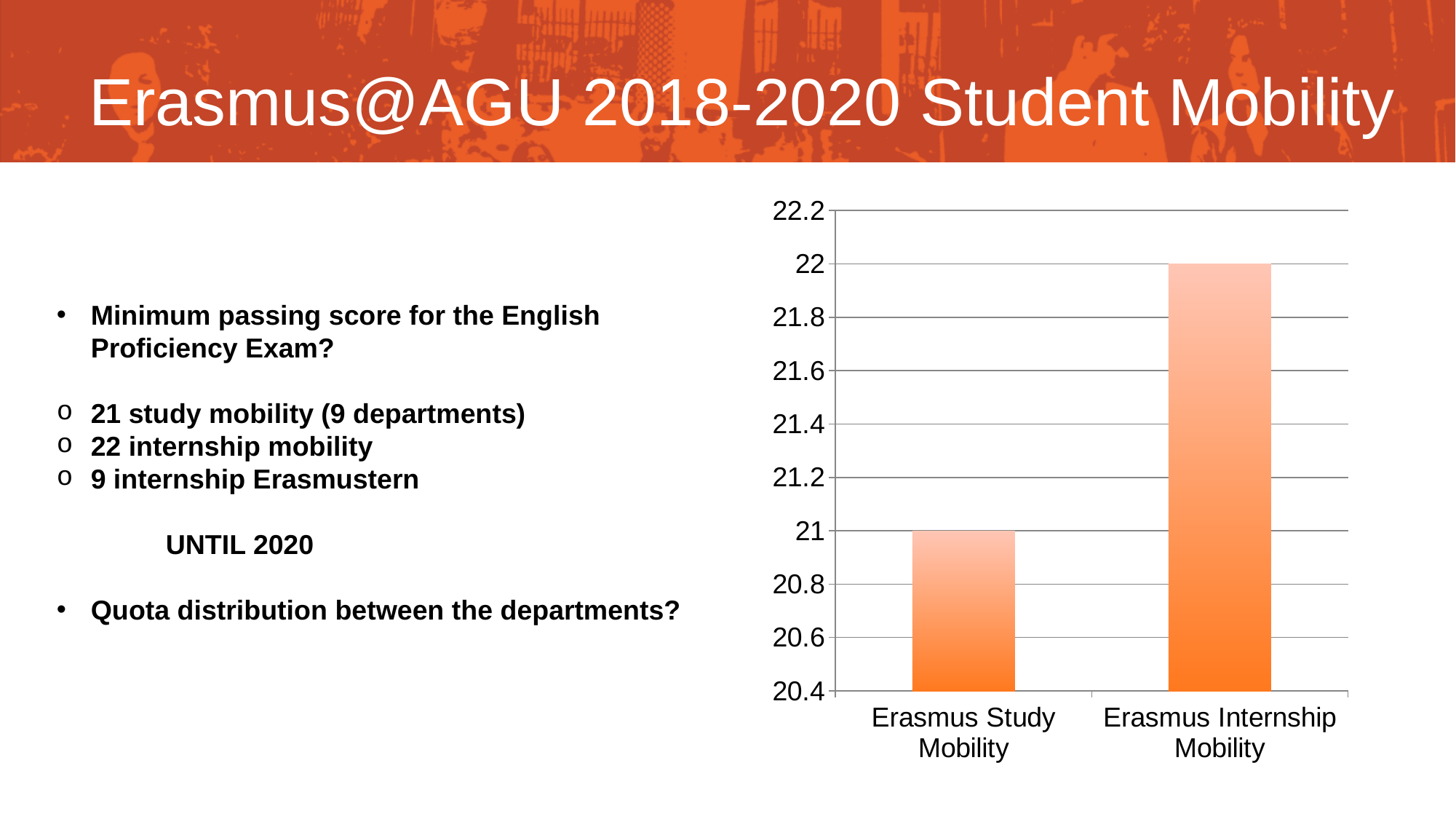
Which category has the highest value? Erasmus Internship Mobility What is the lowest value shown on the chart's vertical axis? 20.4 What is the difference between the values for Erasmus Internship Mobility and Erasmus Study Mobility? 1 Do the values rise or fall from Erasmus Study Mobility to Erasmus Internship Mobility? rise What is the value for Erasmus Internship Mobility? 22 Is the value for Erasmus Study Mobility greater or less than 21.4? less How many categories are shown on the chart? 2 Which category has the lowest value? Erasmus Study Mobility What is the value for Erasmus Study Mobility? 21 What kind of chart is shown on the slide? bar chart Which is larger, the value for Erasmus Study Mobility or the value for Erasmus Internship Mobility? Erasmus Internship Mobility Is the value for Erasmus Internship Mobility greater or less than 21.6? greater